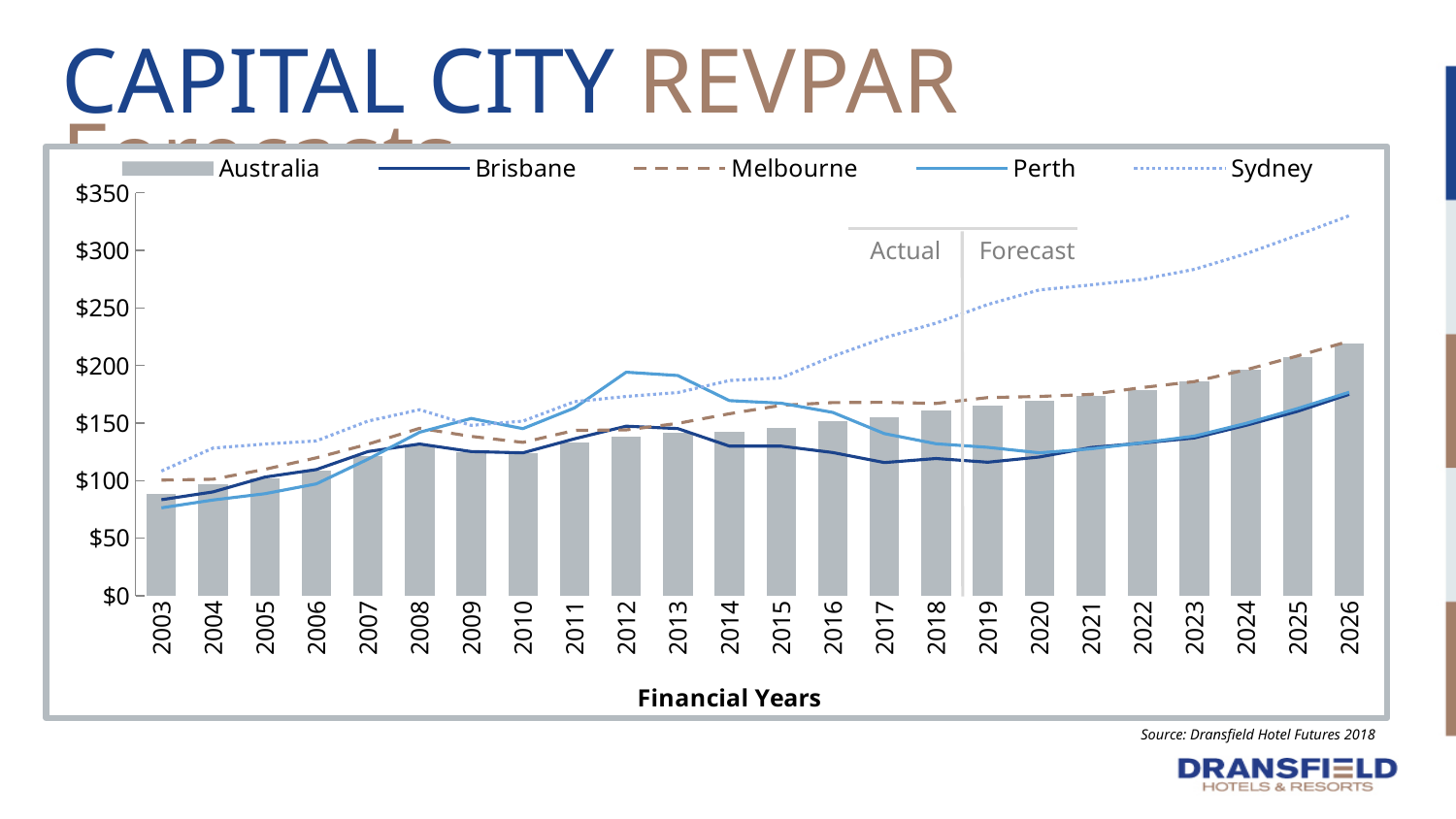
Is the value for Australia in 2003 greater or less than $100? less In which year is the Australia bar the tallest? 2026 Which series has the highest value in 2026? Sydney Which series is plotted as bars? Australia Which is larger in 2020, Sydney or Brisbane? Sydney How many series does the legend list? 5 What kind of chart is this? Combined bar and line chart What is the title of the x axis? Financial Years How many financial years are shown on the x axis? 24 Is the value for Brisbane in 2017 greater or less than $150? less Is the value for Perth in 2012 greater or less than $150? greater